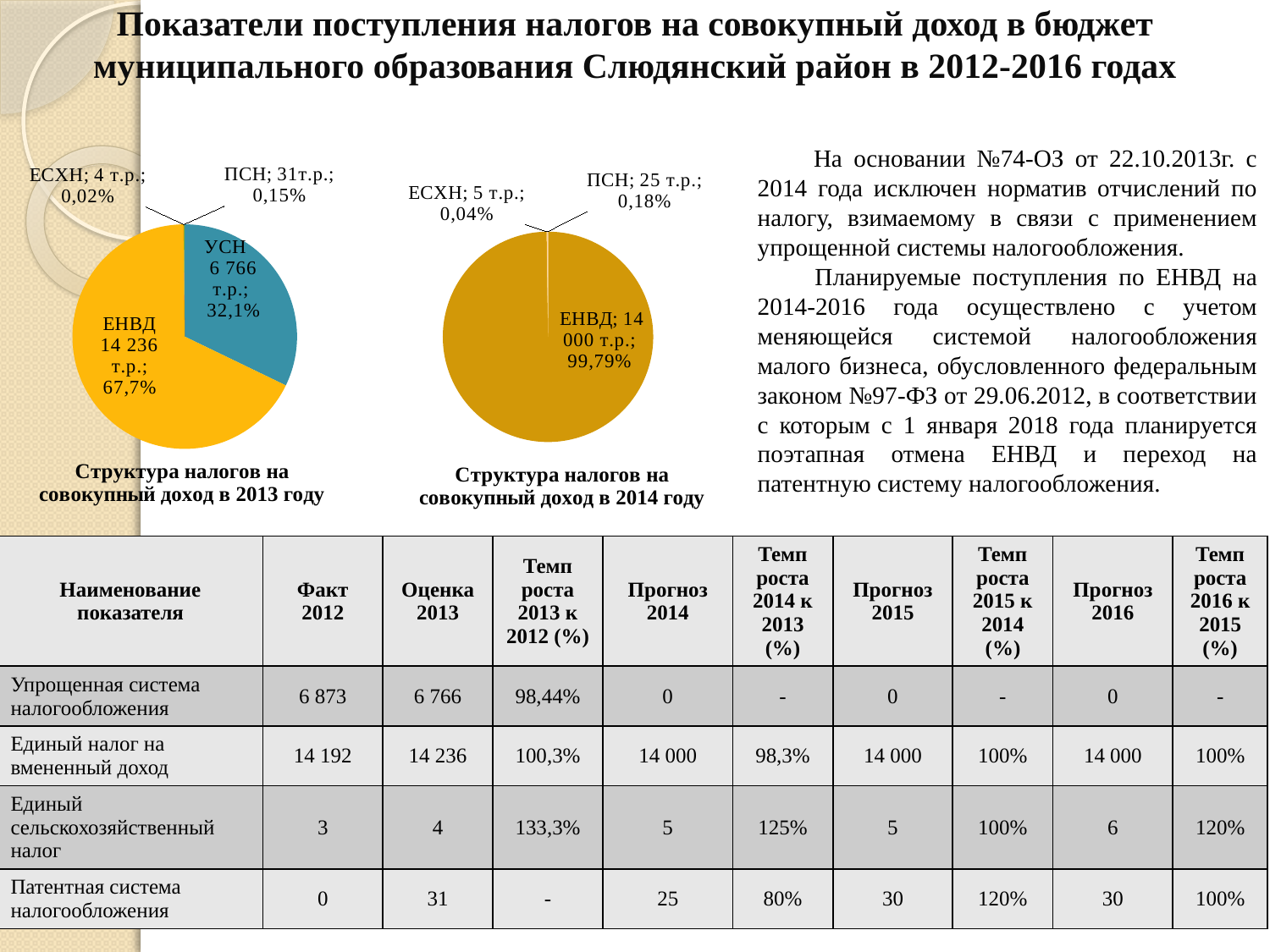
How many categories are shown in the pie chart 'Структура налогов на совокупный доход в 2013 году'? 4 In the pie chart 'Структура налогов на совокупный доход в 2013 году', what is the difference between the ЕНВД and УСН values? 7 470 т.р. In the pie chart 'Структура налогов на совокупный доход в 2013 году', what share of the pie does УСН have? 32,1% In the pie chart 'Структура налогов на совокупный доход в 2013 году', which category has the largest slice? ЕНВД In the pie chart 'Структура налогов на совокупный доход в 2014 году', what share of the pie does ЕНВД have? 99,79% How many pie charts are shown on the slide? 2 In the pie chart 'Структура налогов на совокупный доход в 2014 году', what is the value for ЕСХН? 5 т.р. In the pie chart 'Структура налогов на совокупный доход в 2014 году', what is the value for ПСН? 25 т.р. In the pie chart 'Структура налогов на совокупный доход в 2013 году', which category has the smallest slice? ЕСХН In the pie chart 'Структура налогов на совокупный доход в 2013 году', what is the value for ЕНВД? 14 236 т.р. In the pie chart 'Структура налогов на совокупный доход в 2014 году', which is larger, ПСН or ЕСХН? ПСН What type of chart is 'Структура налогов на совокупный доход в 2014 году'? Pie chart